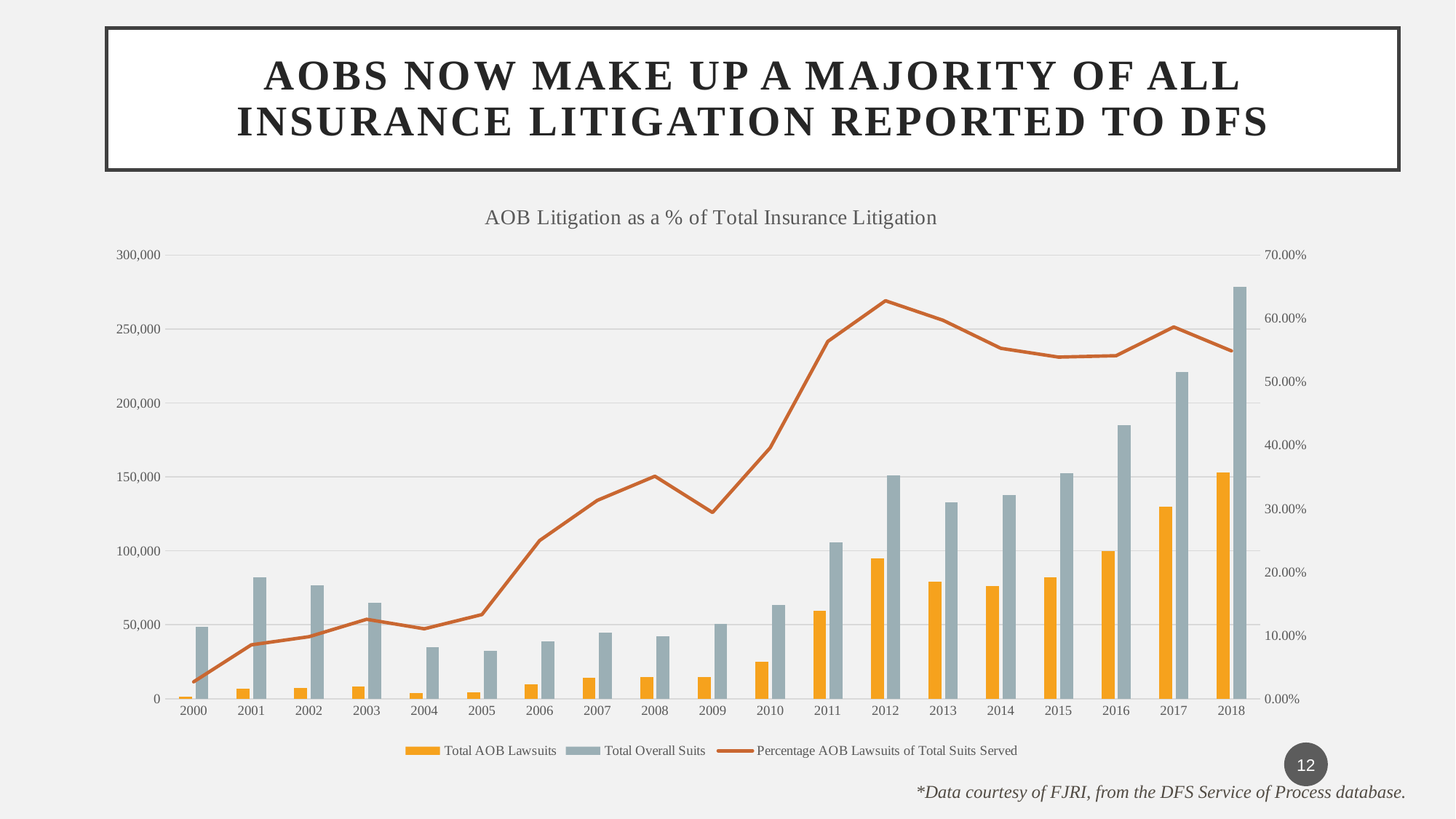
In which year is the Total AOB Lawsuits bar the highest? 2018 Does the Percentage AOB Lawsuits of Total Suits Served line rise or fall from 2009 to 2012? rise Is the value for Total Overall Suits in 2018 greater or less than 250,000? greater In which year is the Total AOB Lawsuits bar the lowest? 2000 Is the Percentage AOB Lawsuits of Total Suits Served in 2012 greater or less than 60.00%? greater In which year is the Total Overall Suits bar the highest? 2018 What kind of chart is shown on the slide? A combined bar and line chart In which year does the Percentage AOB Lawsuits of Total Suits Served line reach its peak? 2012 Which is larger, the Total Overall Suits bar for 2001 or for 2003? 2001 How many series does the legend list? 3 What is the title of the chart? AOB Litigation as a % of Total Insurance Litigation How many years are shown on the x axis? 19